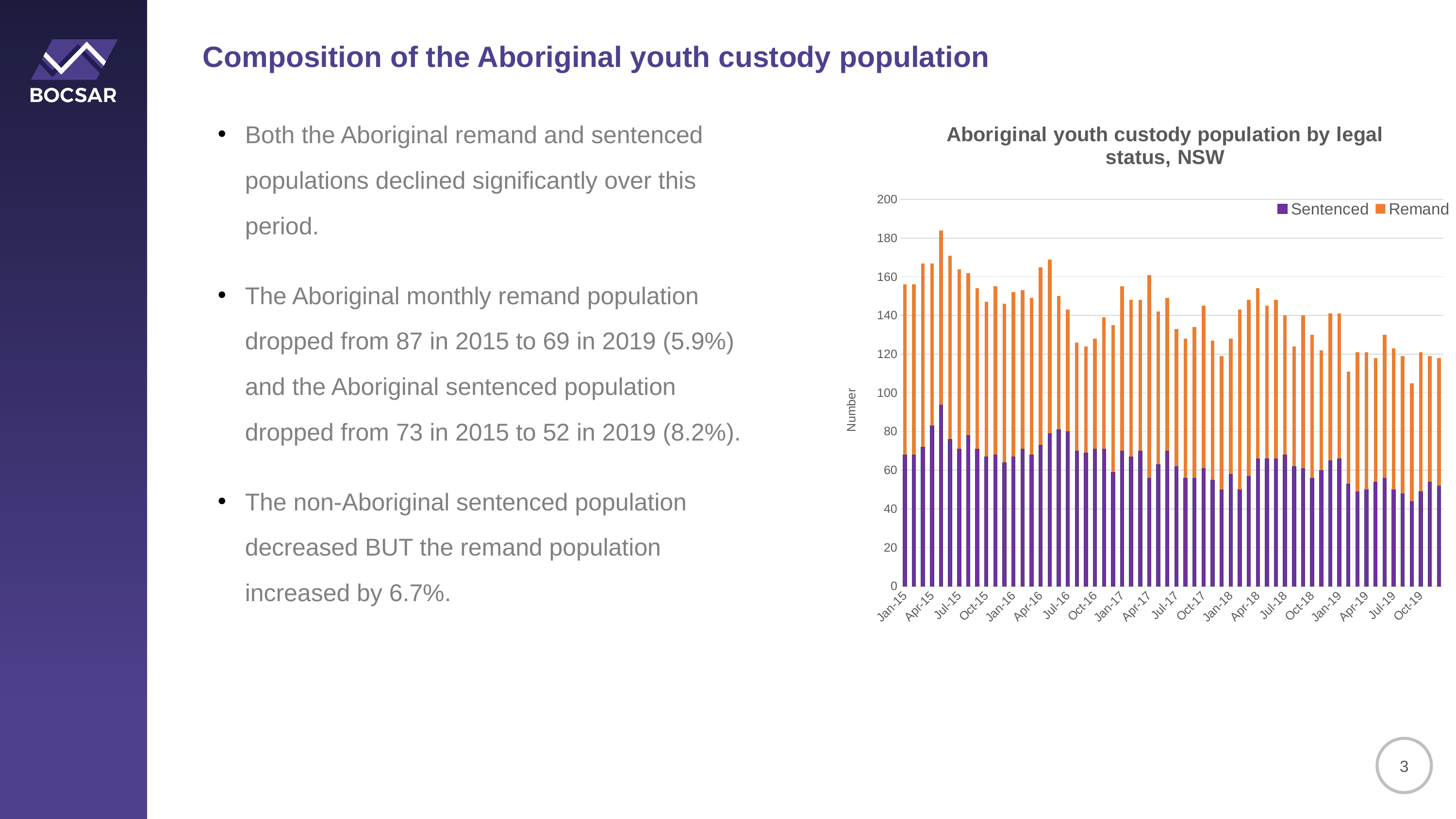
What are the two series named in the chart legend? Sentenced and Remand Is the total custody population for Jan-15 greater or less than 140? greater Is the Sentenced value for Jan-15 greater or less than 60? greater Is the tallest bar in the chart greater or less than 180? greater What is the title of the chart? Aboriginal youth custody population by legal status, NSW How many series does the chart legend list? 2 Do the total bar heights generally rise or fall from Jan-15 to Oct-19? fall What kind of chart is shown on the slide? Stacked bar chart Which series is shown in purple at the bottom of each bar? Sentenced Which is larger, the total custody population in Jan-15 or in Oct-19? Jan-15